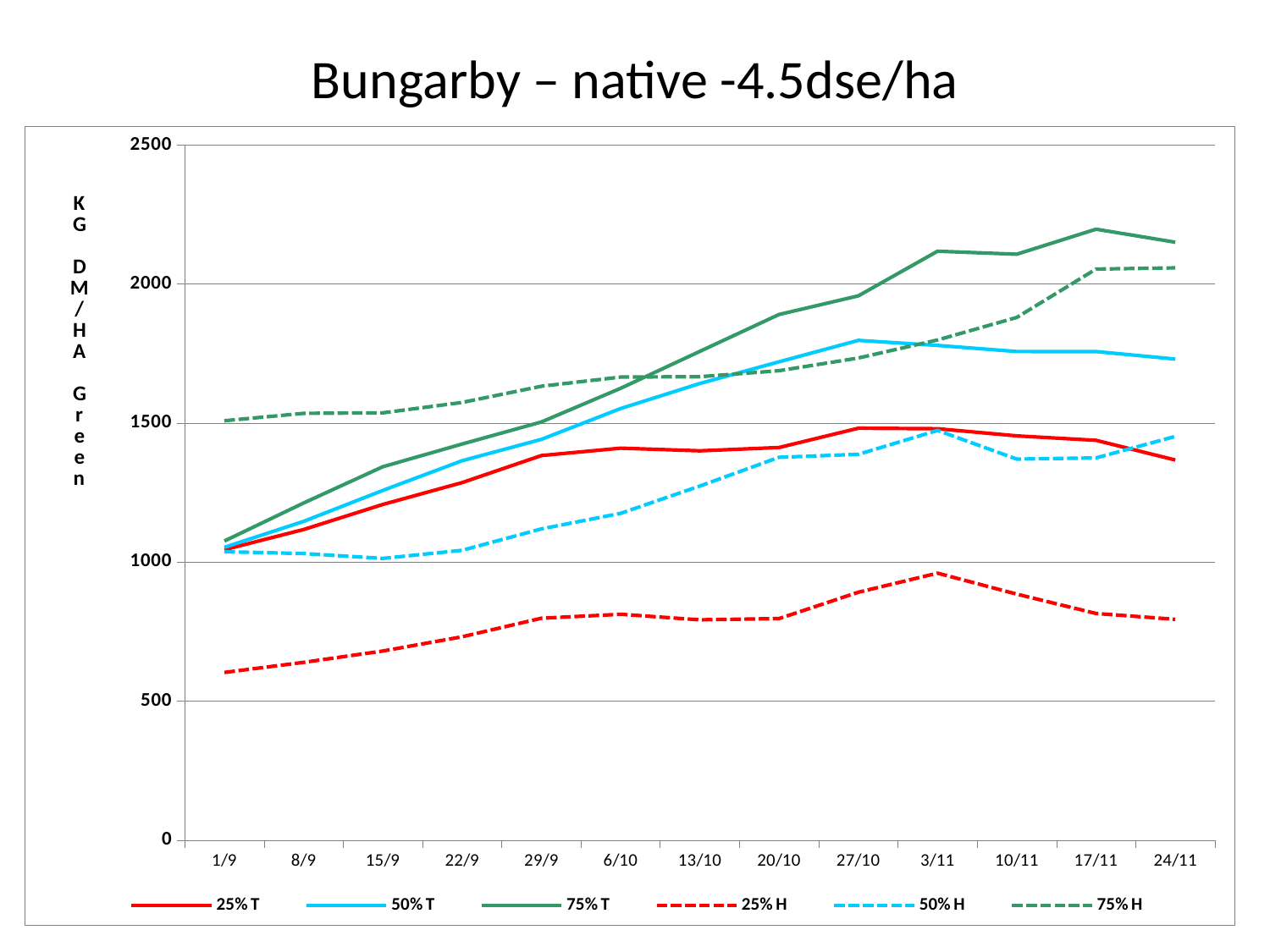
How many dates are shown along the x axis? 13 Is the value for 50% T at 27/10 greater or less than 2000? less Which series has the lowest value at 24/11? 25% H At 20/10, which is larger: 75% T or 25% T? 75% T Is the value for 25% H at 3/11 greater or less than 1000? less Which series has the highest value at 1/9? 75% H How many series does the legend list? 6 What kind of chart is shown on the slide? line chart Which series has the highest value at 24/11? 75% T Is the value for 75% T at 3/11 greater or less than 2000? greater Does the 75% T series generally rise or fall from 1/9 to 3/11? rise